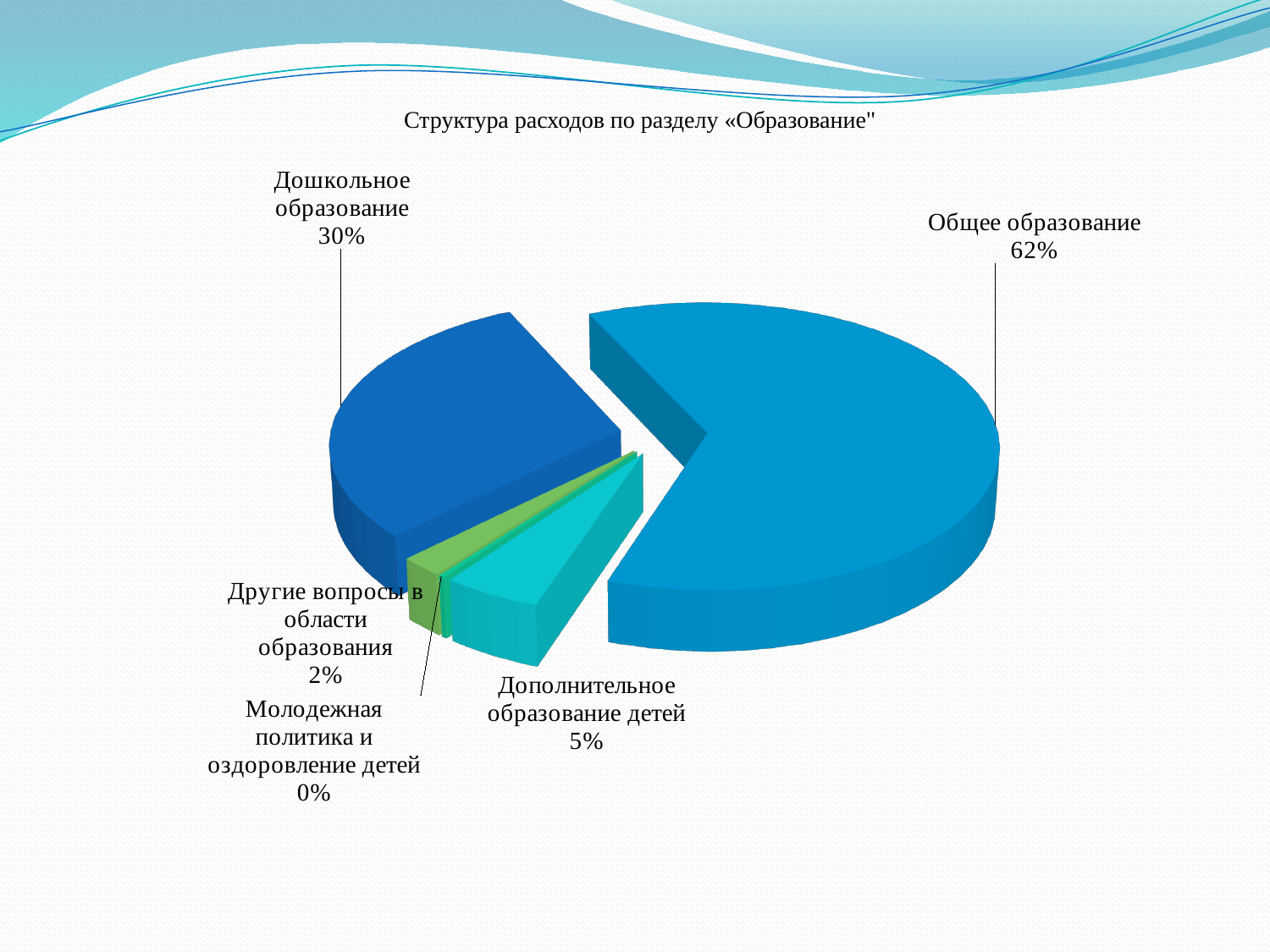
Which is larger: the share for Дополнительное образование детей or the share for Другие вопросы в области образования? Дополнительное образование детей Which category has the smallest share of the pie? Молодежная политика и оздоровление детей What share of the pie does Дополнительное образование детей represent? 5% What is the difference in percentage points between Общее образование and Дошкольное образование? 32 What is the title of the chart? Структура расходов по разделу «Образование" How many categories are shown in the pie chart? 5 What share of the pie does Другие вопросы в области образования represent? 2% What kind of chart is shown on the slide? Pie chart What share of the pie does Дошкольное образование represent? 30% What share of the pie does Молодежная политика и оздоровление детей represent? 0% What share of the pie does Общее образование represent? 62% Which category has the largest share of the pie? Общее образование